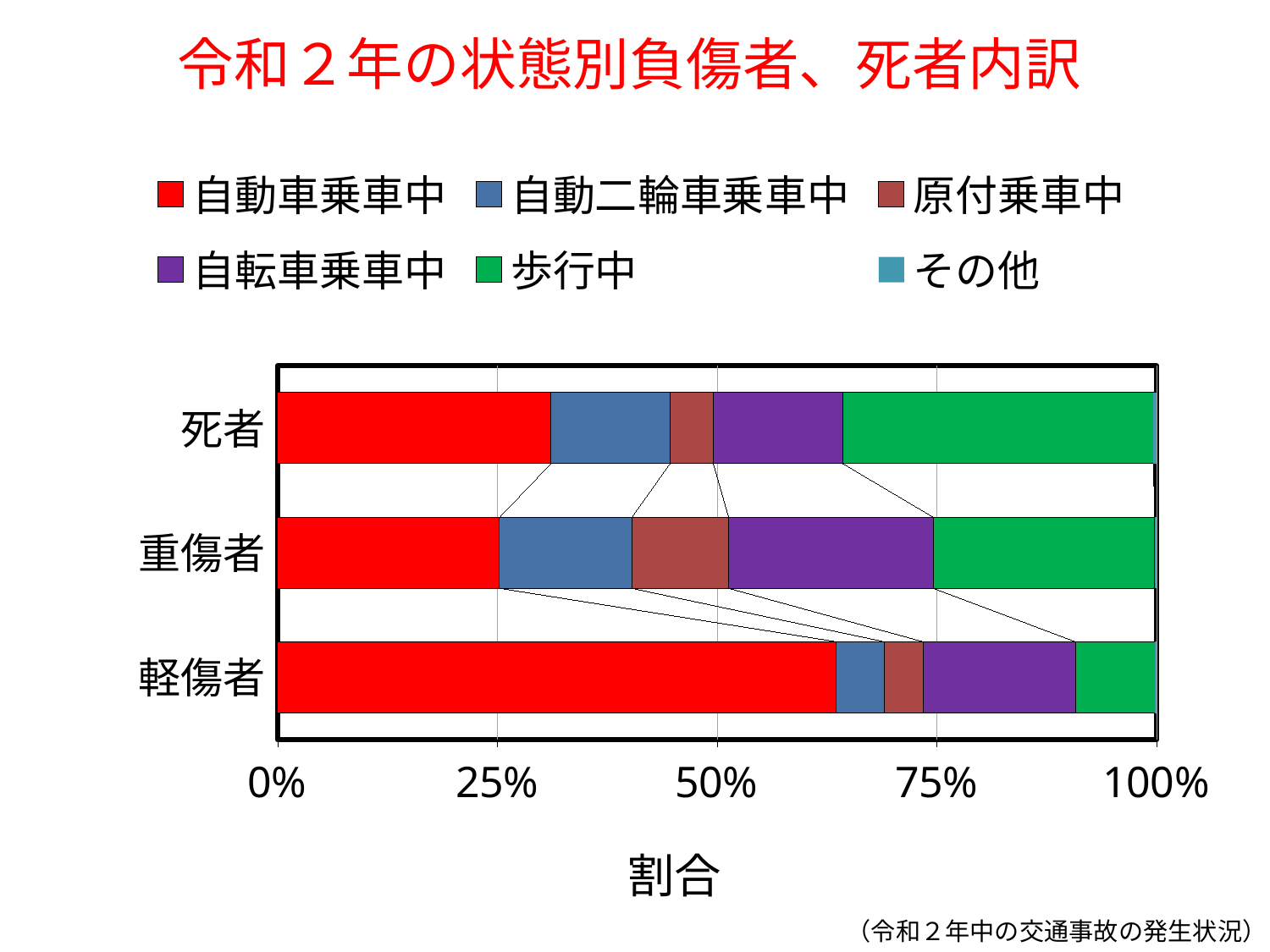
Is the 自動車乗車中 share for 軽傷者 greater or less than 50%? greater Which is larger, the 自動二輪車乗車中 share for 死者 or for 軽傷者? 死者 How many categories (bars) are plotted on the chart? 3 Which category has the largest 歩行中 share? 死者 Is the 自動車乗車中 share for 死者 greater or less than 25%? greater What is the title of the chart? 令和２年の状態別負傷者、死者内訳 Is the 歩行中 share for 死者 greater or less than 25%? greater What is the label of the horizontal axis? 割合 Which category has the largest 自動車乗車中 share? 軽傷者 What kind of chart is shown on the slide? stacked bar chart How many series does the legend list? 6